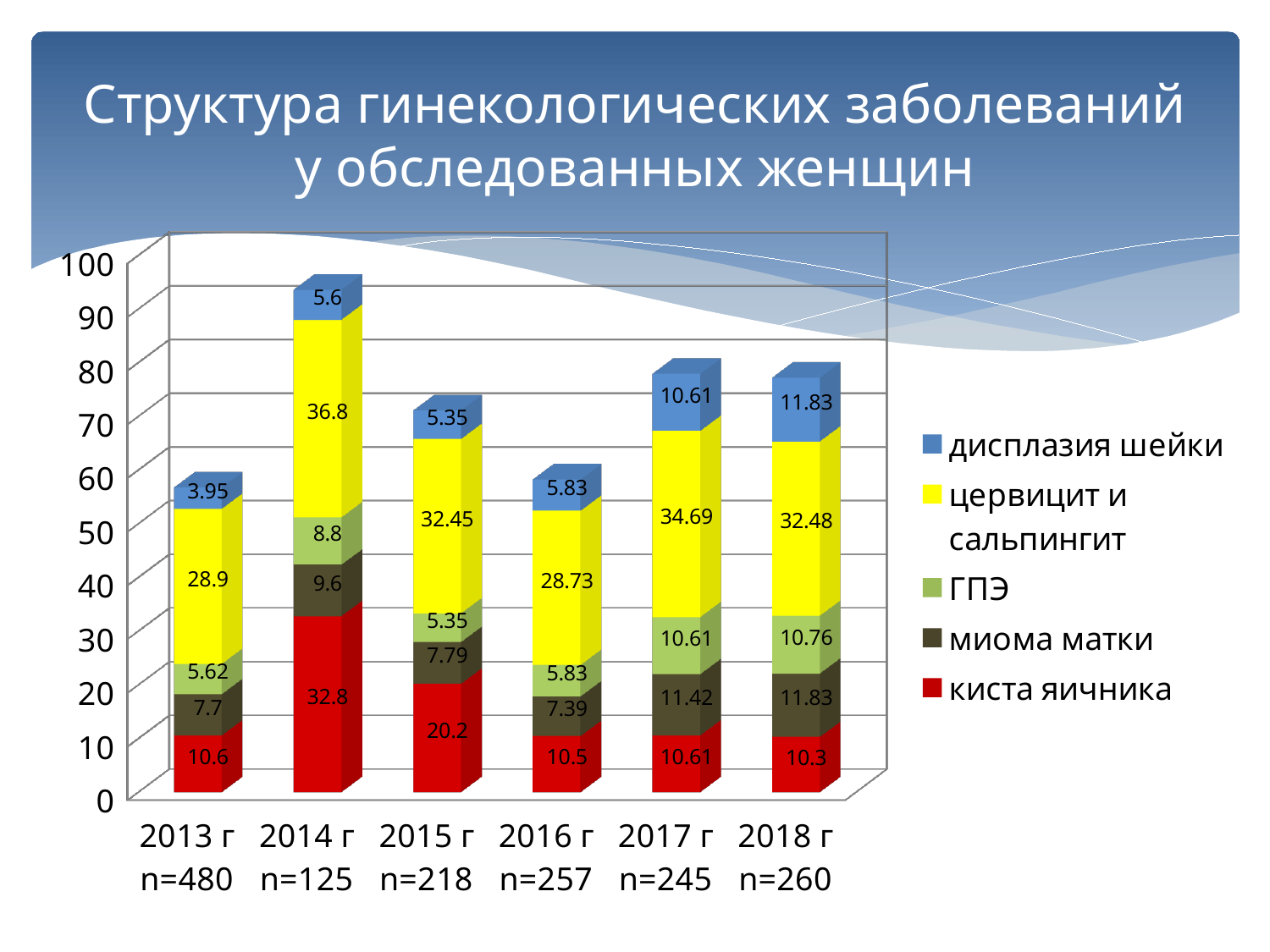
Which series is shown in red? киста яичника How many years are shown on the x axis? 6 What is the value for дисплазия шейки in 2013 г? 3.95 What is the value for киста яичника in 2014 г? 32.8 What kind of chart is shown on the slide? Stacked bar chart How many series does the legend list? 5 What is the value for цервицит и сальпингит in 2017 г? 34.69 In which year is the value for дисплазия шейки the lowest? 2013 г Which is larger: the миома матки value for 2018 г or for 2015 г? 2018 г What is the difference between the цервицит и сальпингит values for 2014 г and 2013 г? 7.9 In which year is the value for киста яичника the highest? 2014 г What is the total of the stacked bar for 2014 г? 93.6